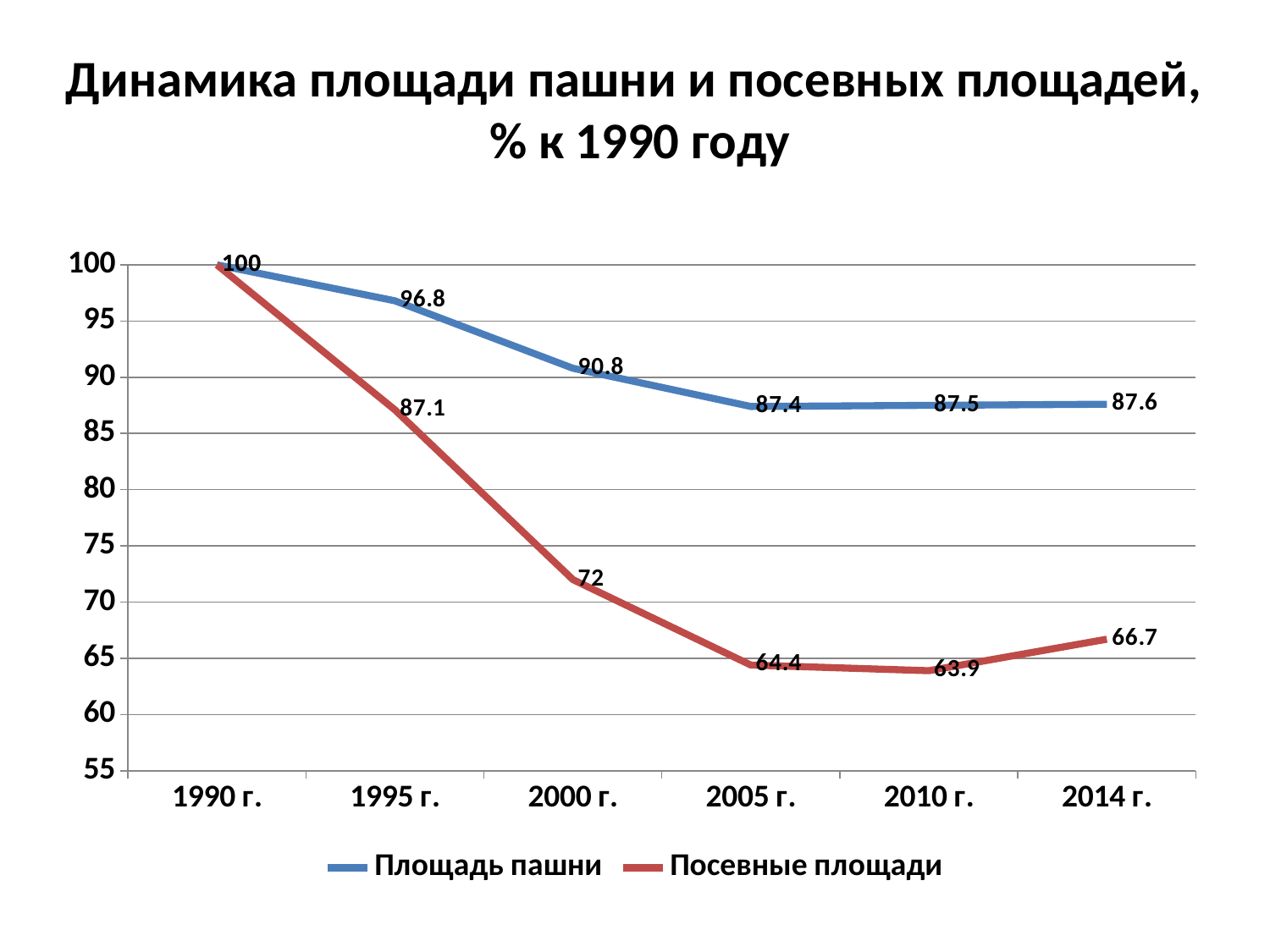
In which year is the value for Посевные площади lowest? 2010 г. Does the value for Посевные площади rise or fall from 1990 г. to 2005 г.? fall What is the value for Посевные площади in 2014 г.? 66.7 What kind of chart is shown on the slide? line chart How many series does the legend list? 2 What is the value for Площадь пашни in 1995 г.? 96.8 How many years are shown on the x axis? 6 What is the difference between the Площадь пашни values in 2000 г. and 2005 г.? 3.4 What is the value for Посевные площади in 2000 г.? 72 Which series has the larger value in 2010 г., Площадь пашни or Посевные площади? Площадь пашни Which colour is used for the Посевные площади line? red What is the difference between Площадь пашни and Посевные площади in 2005 г.? 23